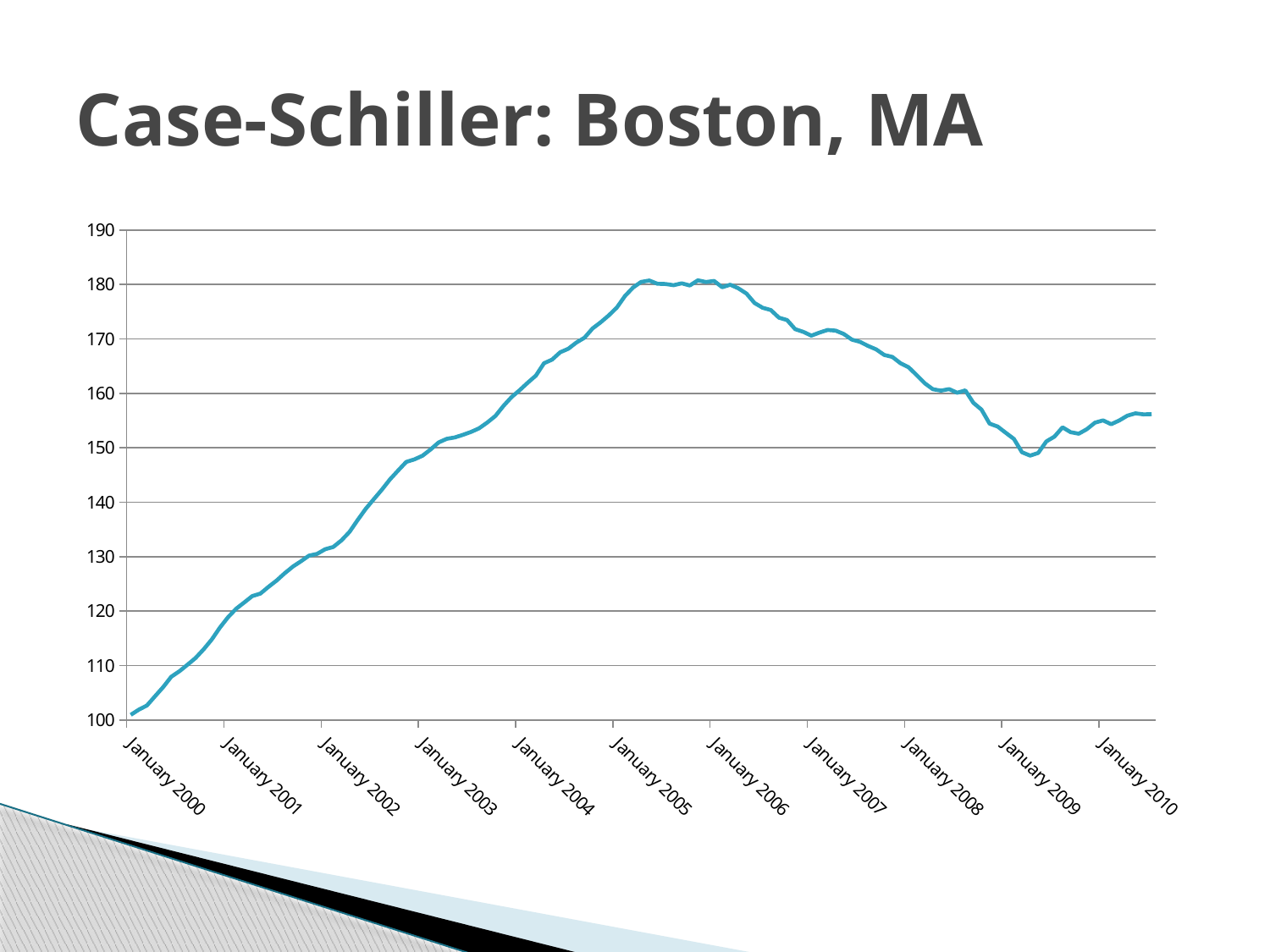
Is the value for January 2002 greater or less than 140? less Is the value for January 2010 greater or less than 150? greater Is the value for January 2008 greater or less than 170? less Does the line rise or fall between January 2006 and January 2009? Falls Does the line rise or fall between January 2000 and January 2005? Rises Which labelled x-axis point has the lowest value? January 2000 How many labelled points are there on the x axis? 11 What is the title of the slide? Case-Schiller: Boston, MA What kind of chart is shown on the slide? Line chart